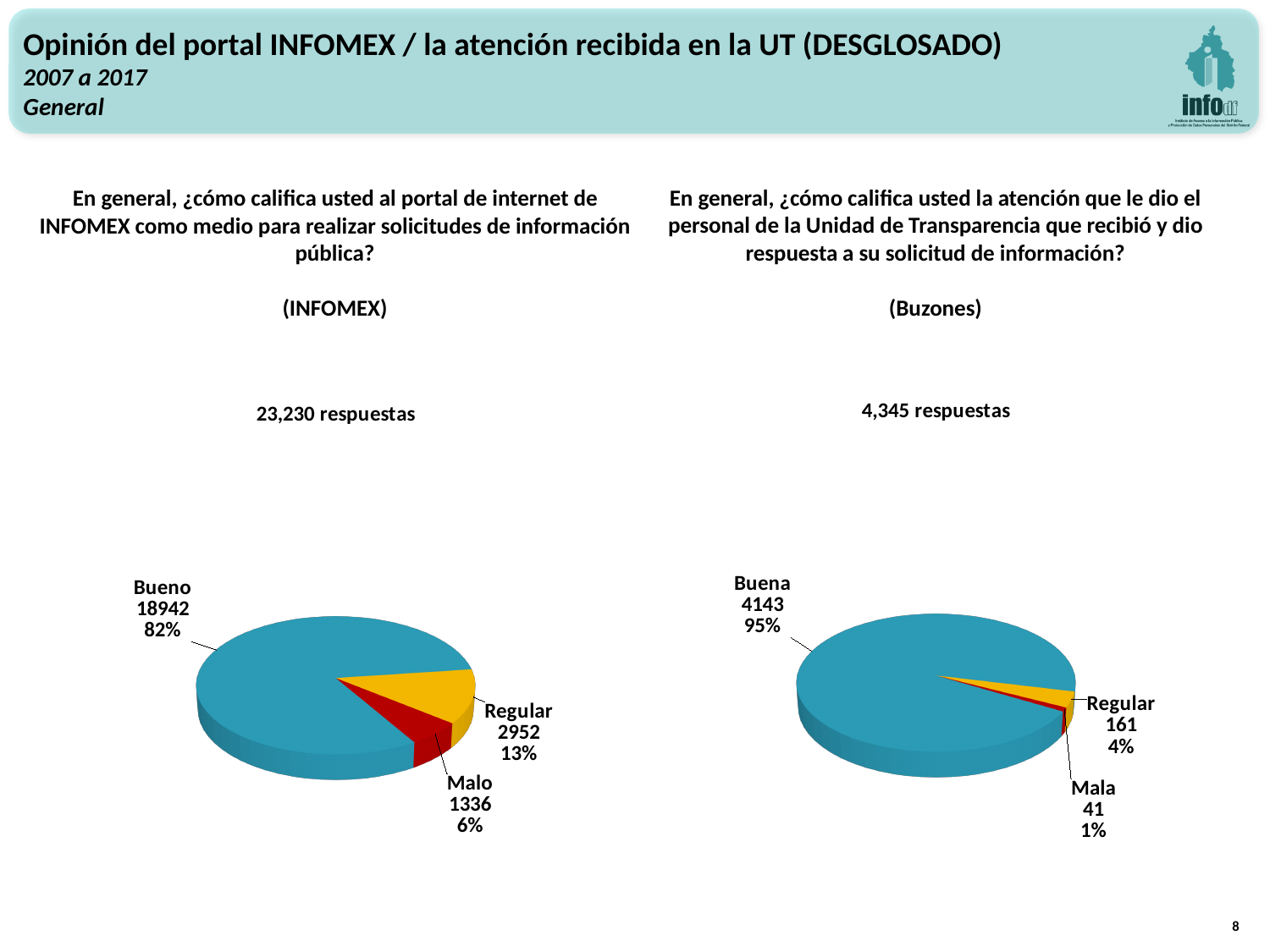
On the right (Buzones) pie chart, how many categories are shown? 3 On the left (INFOMEX) pie chart, what percentage share does Regular have? 13% How many total responses are reported for the right (Buzones) chart? 4,345 respuestas On the left (INFOMEX) pie chart, how many responses are labelled Malo? 1336 On the right (Buzones) pie chart, which is larger, Regular or Mala? Regular On the right (Buzones) pie chart, what percentage share does Mala have? 1% What kind of chart is used on the left (INFOMEX) side of the slide? Pie chart On the left (INFOMEX) pie chart, how many responses are labelled Bueno? 18942 On the right (Buzones) pie chart, which category has the largest slice? Buena On the right (Buzones) pie chart, how many responses are labelled Buena? 4143 On the left (INFOMEX) pie chart, what is the difference between the Regular and Malo counts? 1616 On the left (INFOMEX) pie chart, which category has the smallest slice? Malo